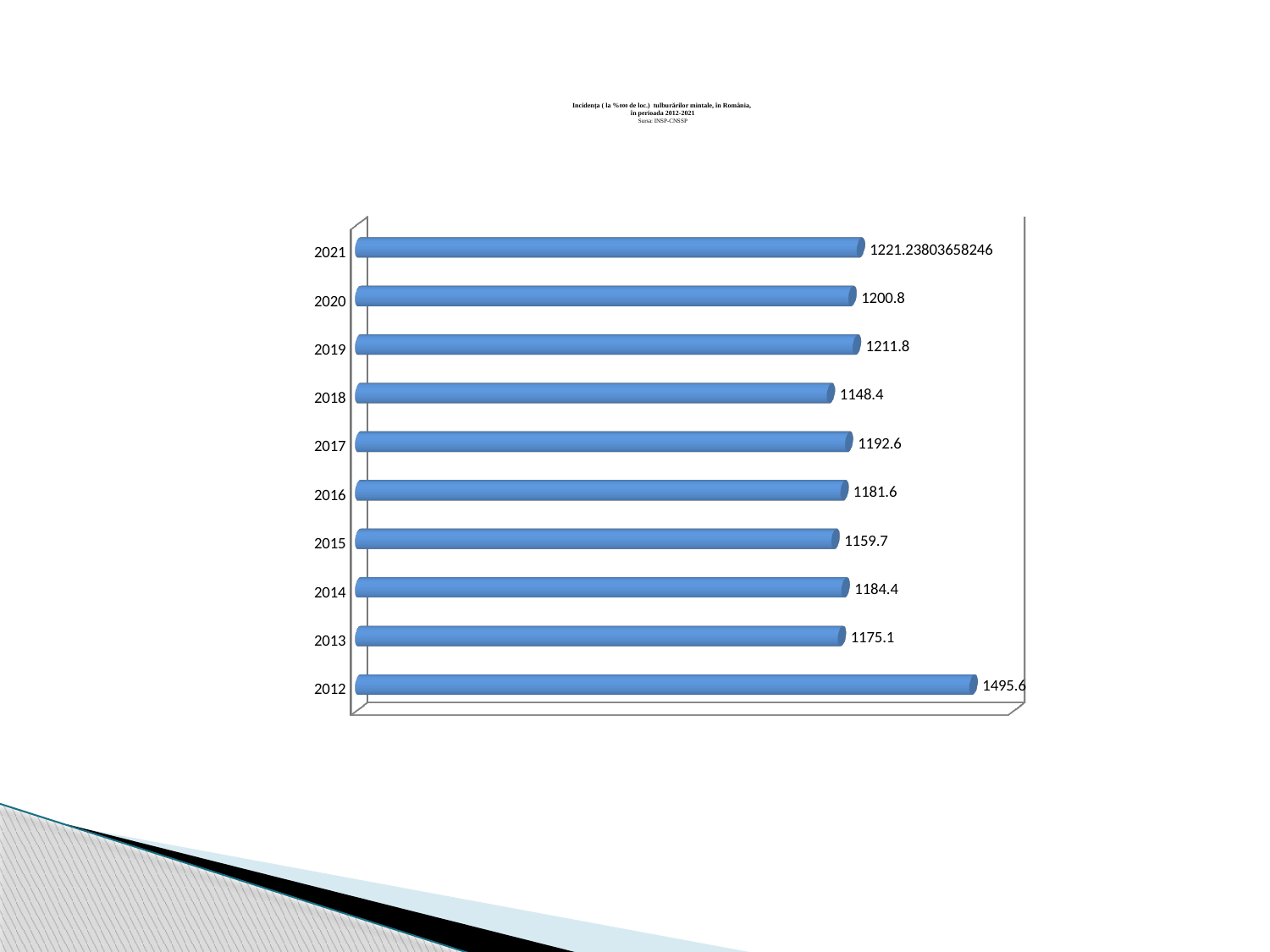
Which is larger, the value for 2019 or the value for 2020? 2019 Did the value rise or fall from 2012 to 2013? fall What kind of chart is shown on the slide? bar chart Which year has the lowest value? 2018 What is the difference between the values for 2014 and 2015? 24.7 What is the value for 2020? 1200.8 What is the difference between the values for 2012 and 2013? 320.5 How many years are plotted in the chart? 10 What is the value for 2012? 1495.6 Which year has the highest value? 2012 What is the value for 2015? 1159.7 What is the value for 2018? 1148.4